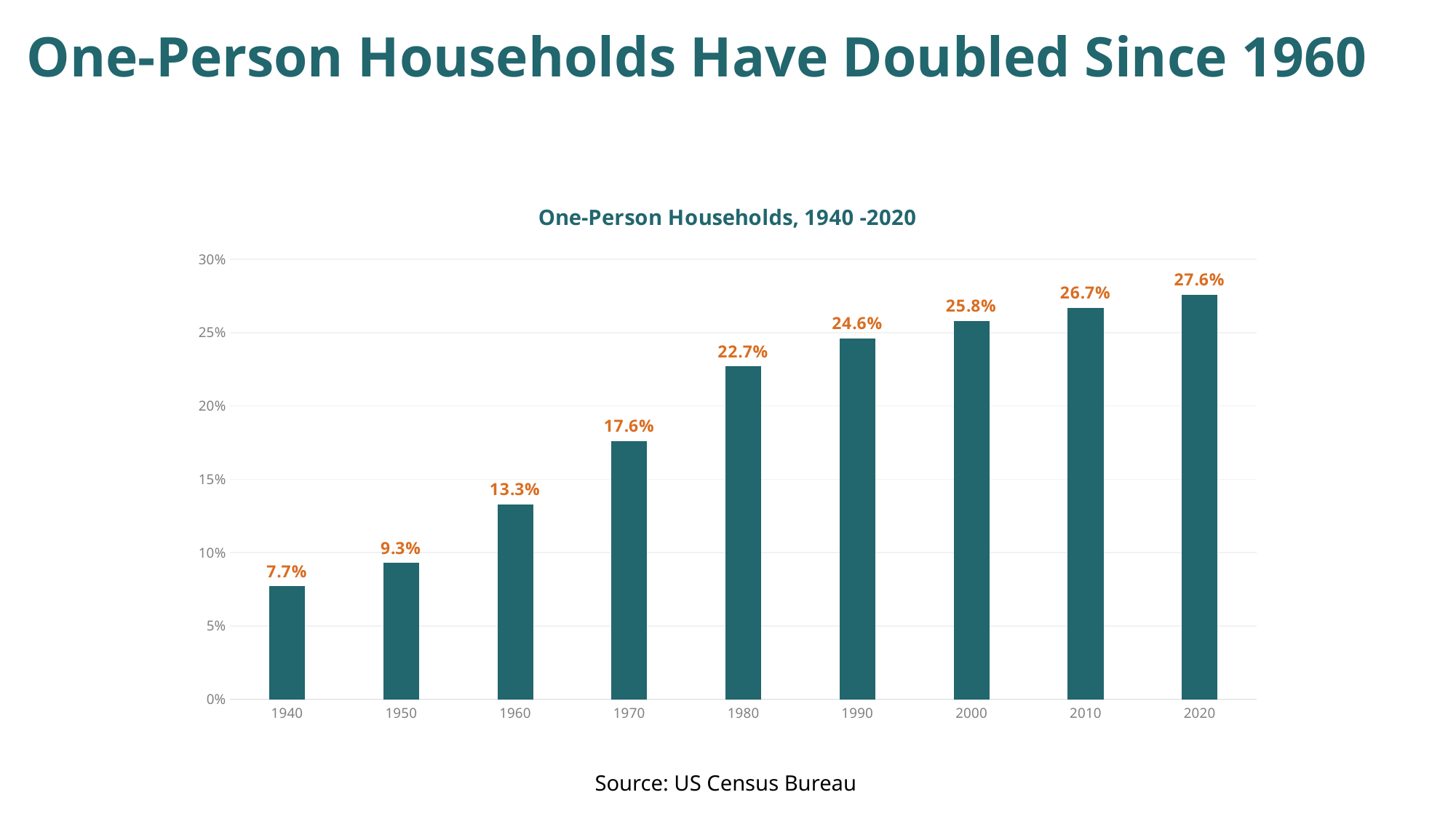
What is the value for 1990? 24.6% Which is larger, the value for 1950 or the value for 1970? 1970 Do the values rise or fall from 1940 to 2020? rise What is the difference between the values for 1980 and 1970? 5.1% Which year has the highest value? 2020 What kind of chart is this? bar chart What is the difference between the values for 2020 and 1960? 14.3% Which year has the lowest value? 1940 What is the value for 1940? 7.7% How many years are shown on the x axis? 9 Is the value for 2000 greater or less than 25%? greater What is the value for 1960? 13.3%